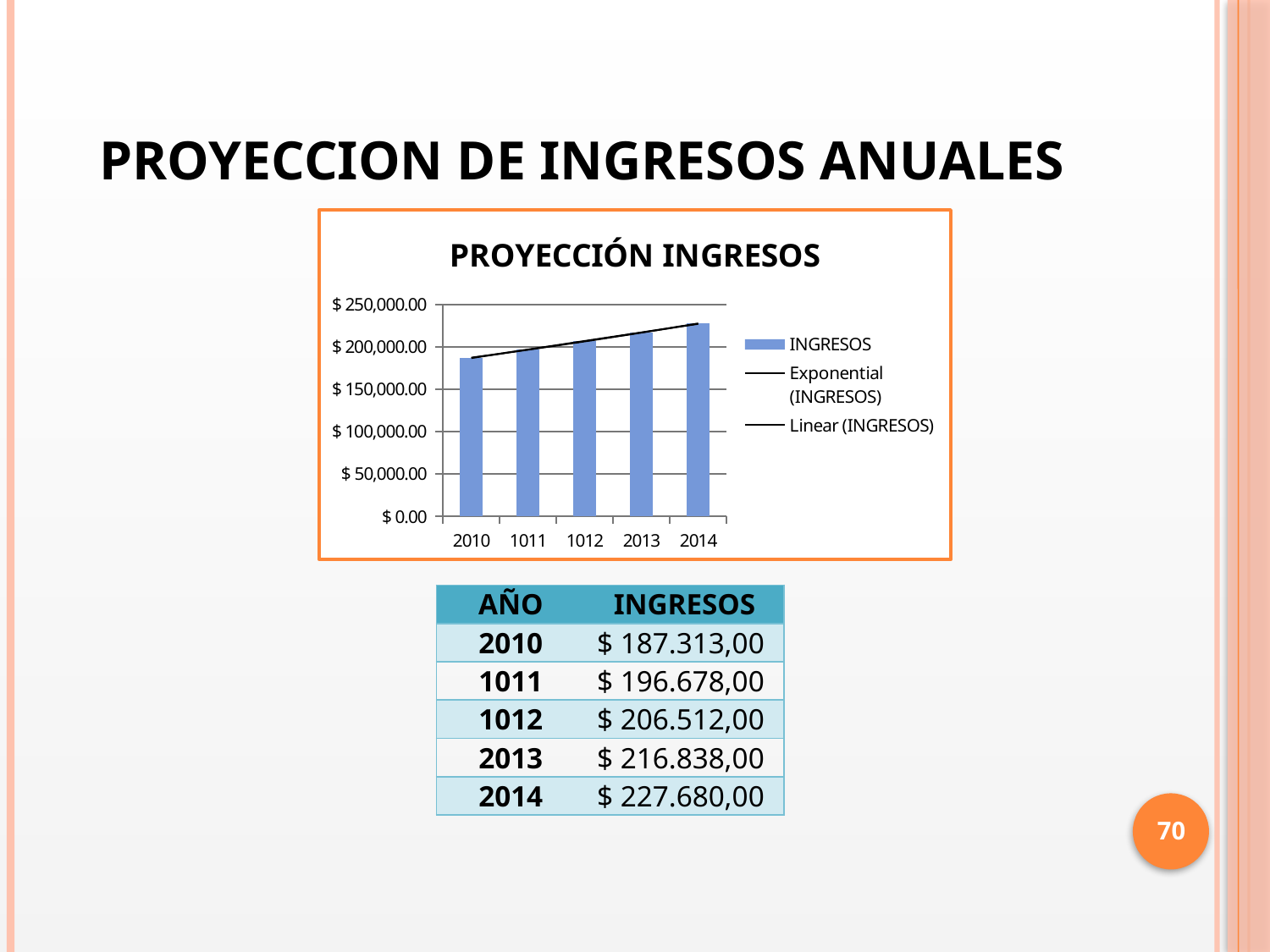
According to the table, what is the INGRESOS value for 2013? $ 216.838,00 Is the INGRESOS value for 2014 greater or less than $ 200,000.00? greater Is the INGRESOS value for 2010 greater or less than $ 200,000.00? less How many entries does the chart legend list? 3 Which year has the lowest INGRESOS value? 2010 What kind of chart is shown on the slide? bar chart Which is larger, the INGRESOS value for 2013 or for 2010? 2013 According to the table, what is the INGRESOS value for 2010? $ 187.313,00 Which year has the highest INGRESOS value? 2014 Do the INGRESOS values rise or fall from 2010 to 2014? rise How many bars (categories) does the chart show? 5 What is the title of the chart? PROYECCIÓN INGRESOS